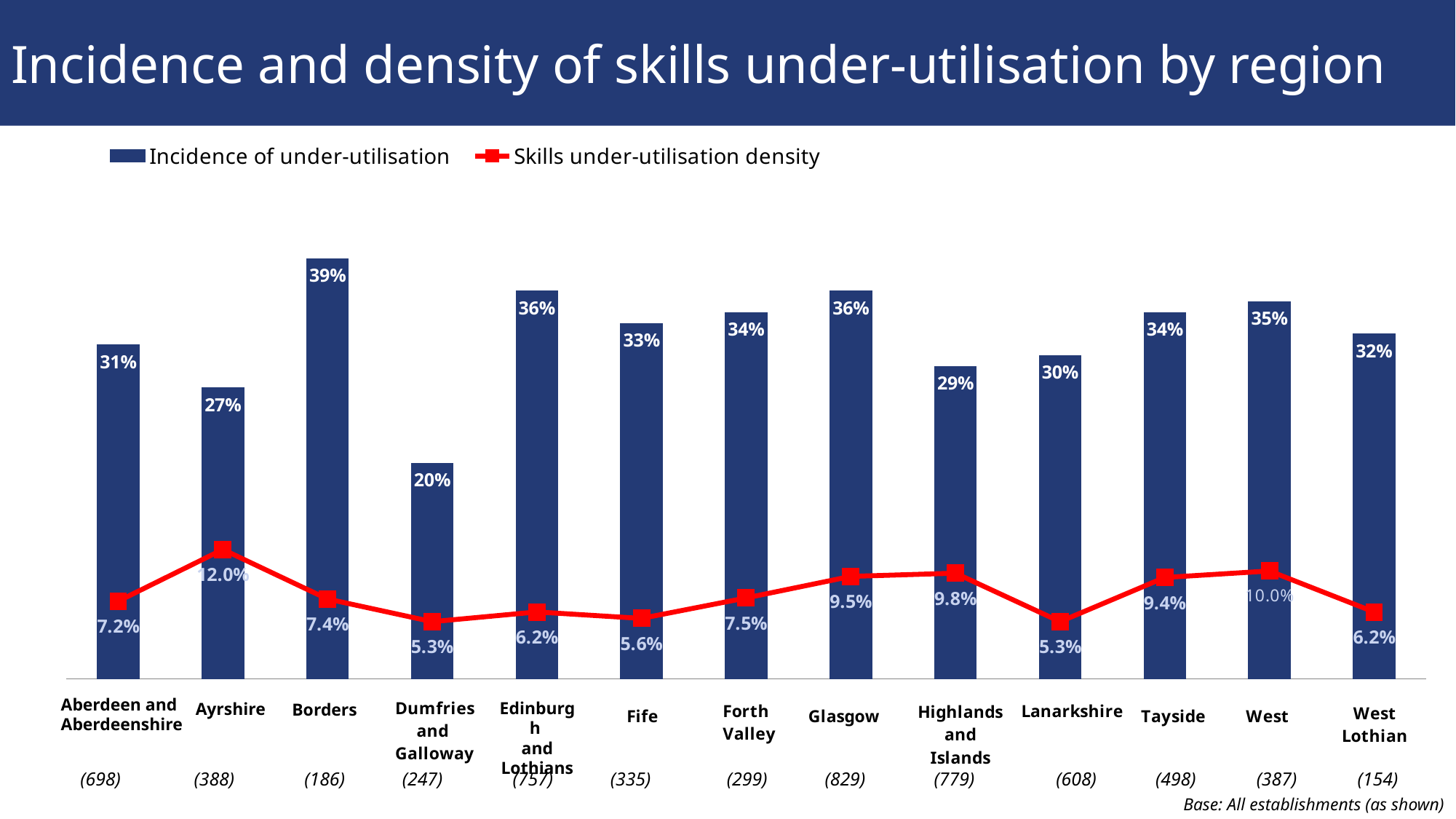
What is the difference in incidence of under-utilisation between Borders and Dumfries and Galloway? 19 percentage points How many series does the legend list? 2 How many regions are shown on the chart? 13 Which has a higher incidence of under-utilisation, Glasgow or Lanarkshire? Glasgow Which region has the lowest incidence of under-utilisation? Dumfries and Galloway What is the incidence of under-utilisation for Borders? 39% What is the skills under-utilisation density for Ayrshire? 12.0% What is the incidence of under-utilisation for Dumfries and Galloway? 20% Which region has the highest incidence of under-utilisation? Borders What is the base (number of establishments) shown for Glasgow? 829 Which region has the highest skills under-utilisation density? Ayrshire What is the skills under-utilisation density for Highlands and Islands? 9.8%